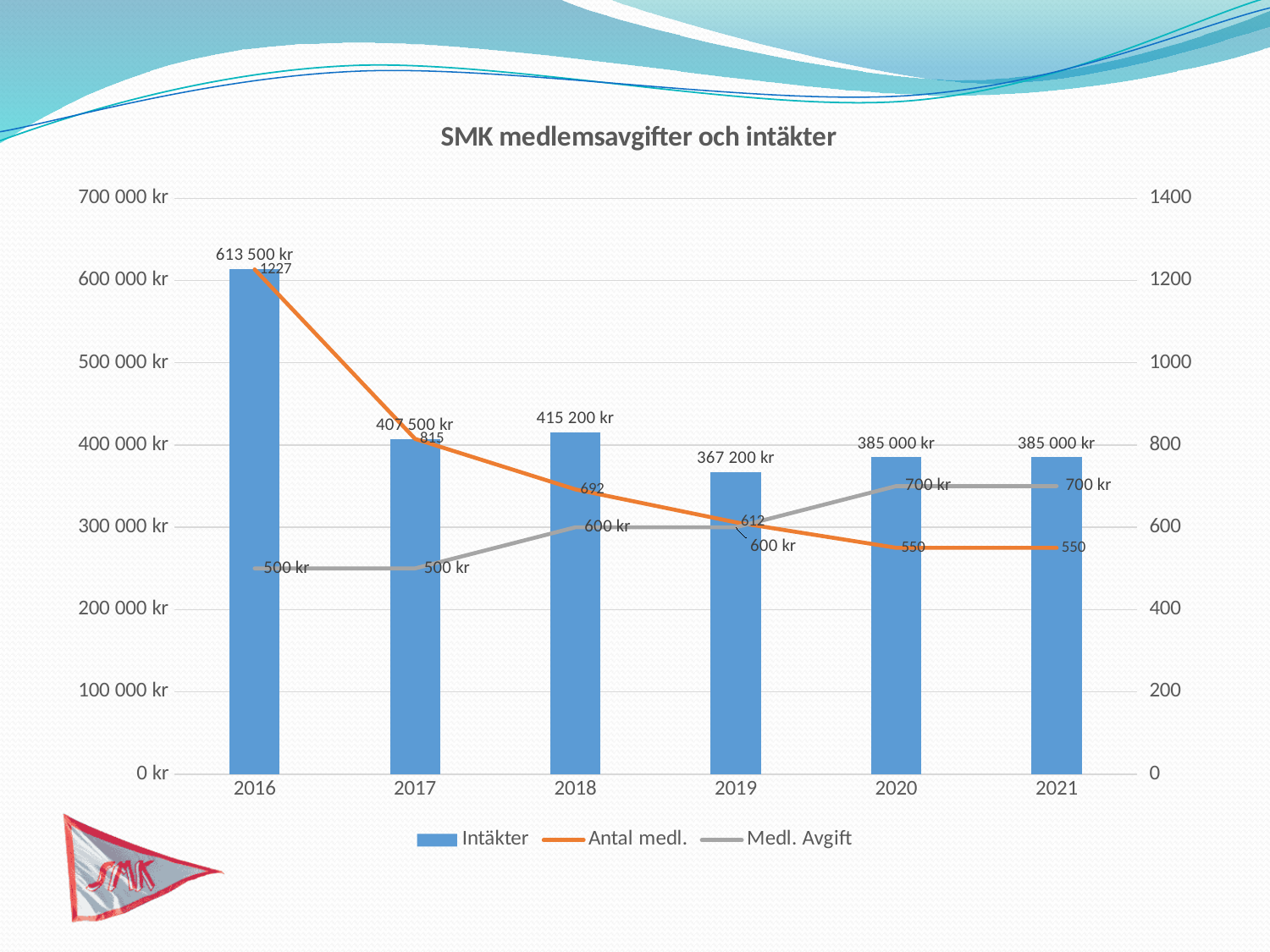
What is the title of the chart? SMK medlemsavgifter och intäkter What is the difference between the Intäkter for 2016 and 2017? 206 000 kr What is the Intäkter value for 2016? 613 500 kr What is the Intäkter value for 2019? 367 200 kr What is the Medl. Avgift value for 2020? 700 kr How many years are shown on the x axis? 6 Which year has the highest Intäkter? 2016 Which year has the lowest Intäkter? 2019 How many series does the legend list? 3 What is the Antal medl. value for 2018? 692 Which is larger, the Intäkter for 2017 or for 2018? 2018 Does the Antal medl. line rise or fall from 2016 to 2019? fall